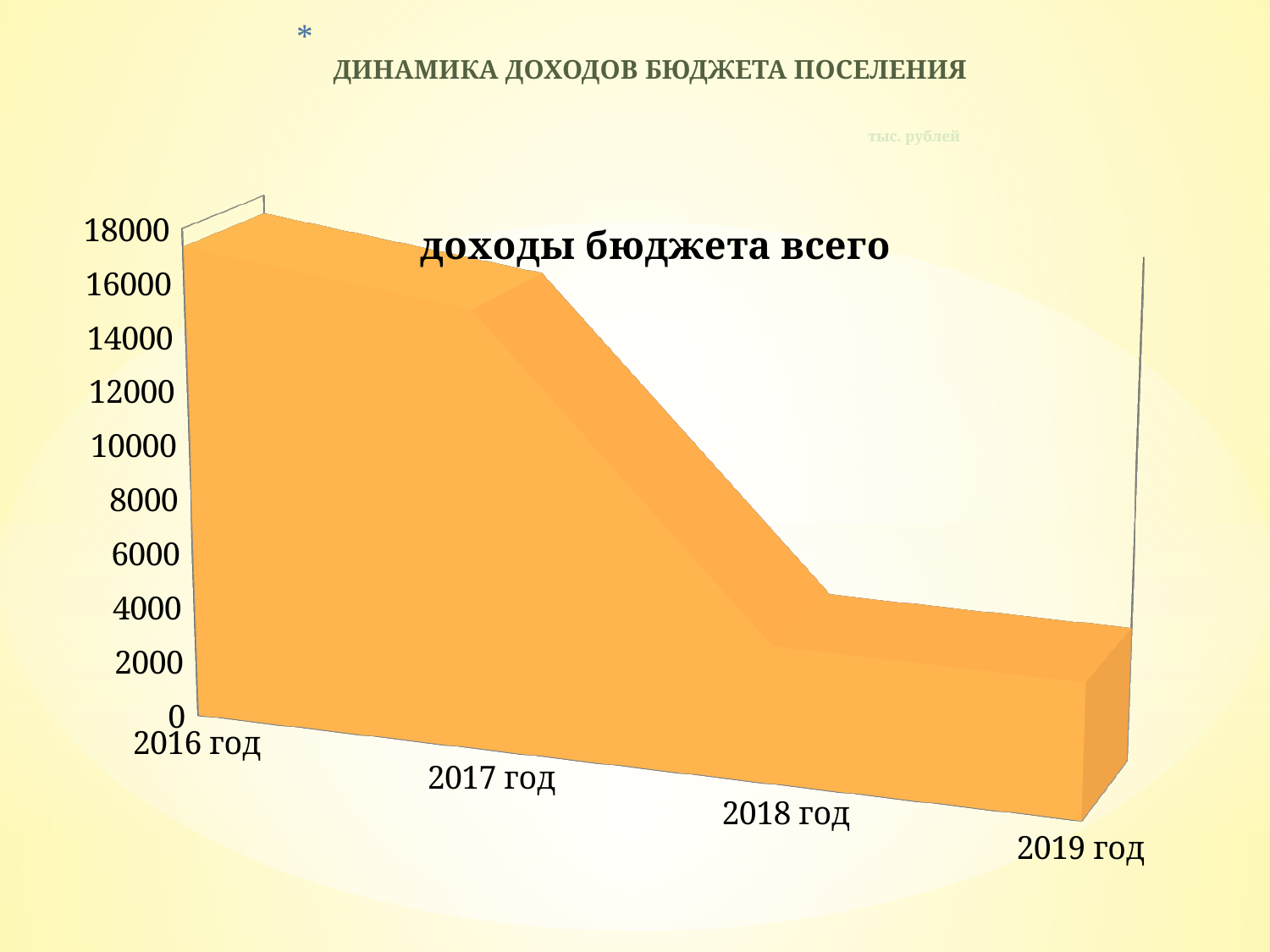
Is the value for 2019 год greater or less than 2000? greater What kind of chart is shown on the slide? area chart Which is larger, the value for 2016 год or the value for 2018 год? 2016 год Do the values rise or fall from 2016 год to 2019 год? fall In what units are the chart values given, according to the slide? тыс. рублей Which year has the highest value in the chart? 2016 год Which is larger, the value for 2017 год or the value for 2019 год? 2017 год How many years are shown on the x axis of the chart? 4 Is the value for 2018 год greater or less than 6000? less Is the value for 2016 год greater or less than 16000? greater What is the title shown inside the chart area? доходы бюджета всего